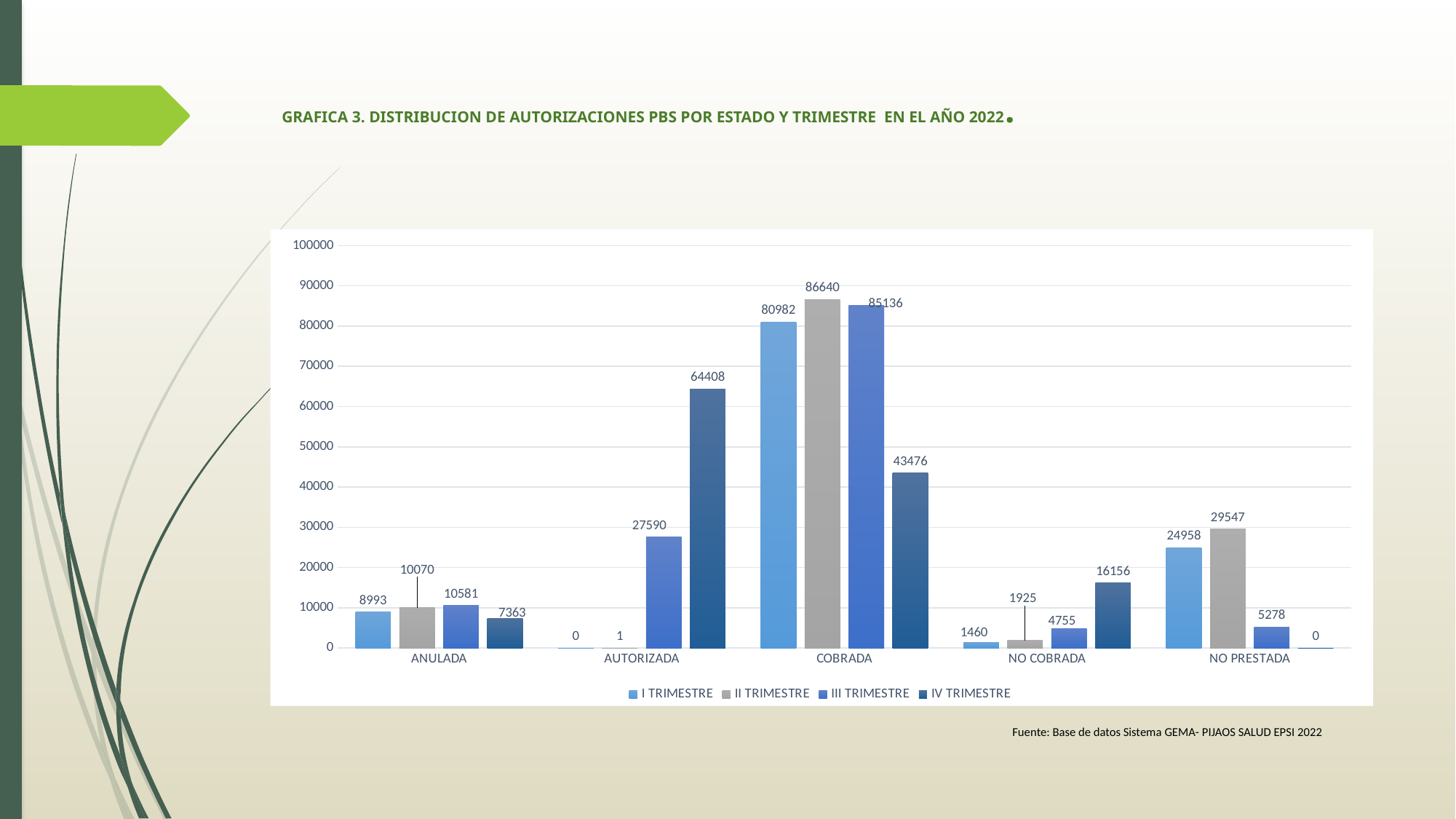
What is the value for COBRADA in the II TRIMESTRE series? 86640 Which category has the lowest value in the I TRIMESTRE series? AUTORIZADA Is the IV TRIMESTRE value for COBRADA greater or less than 40000? greater How many categories are shown on the x axis? 5 What is the difference between the II TRIMESTRE and I TRIMESTRE values for COBRADA? 5658 For NO PRESTADA, which is larger: the I TRIMESTRE value or the II TRIMESTRE value? II TRIMESTRE What is the value for NO COBRADA in the I TRIMESTRE series? 1460 What is the value for AUTORIZADA in the IV TRIMESTRE series? 64408 What is the difference between the IV TRIMESTRE and III TRIMESTRE values for NO COBRADA? 11401 What kind of chart is shown on the slide? bar chart Which category has the highest value in the IV TRIMESTRE series? AUTORIZADA How many series does the legend list? 4